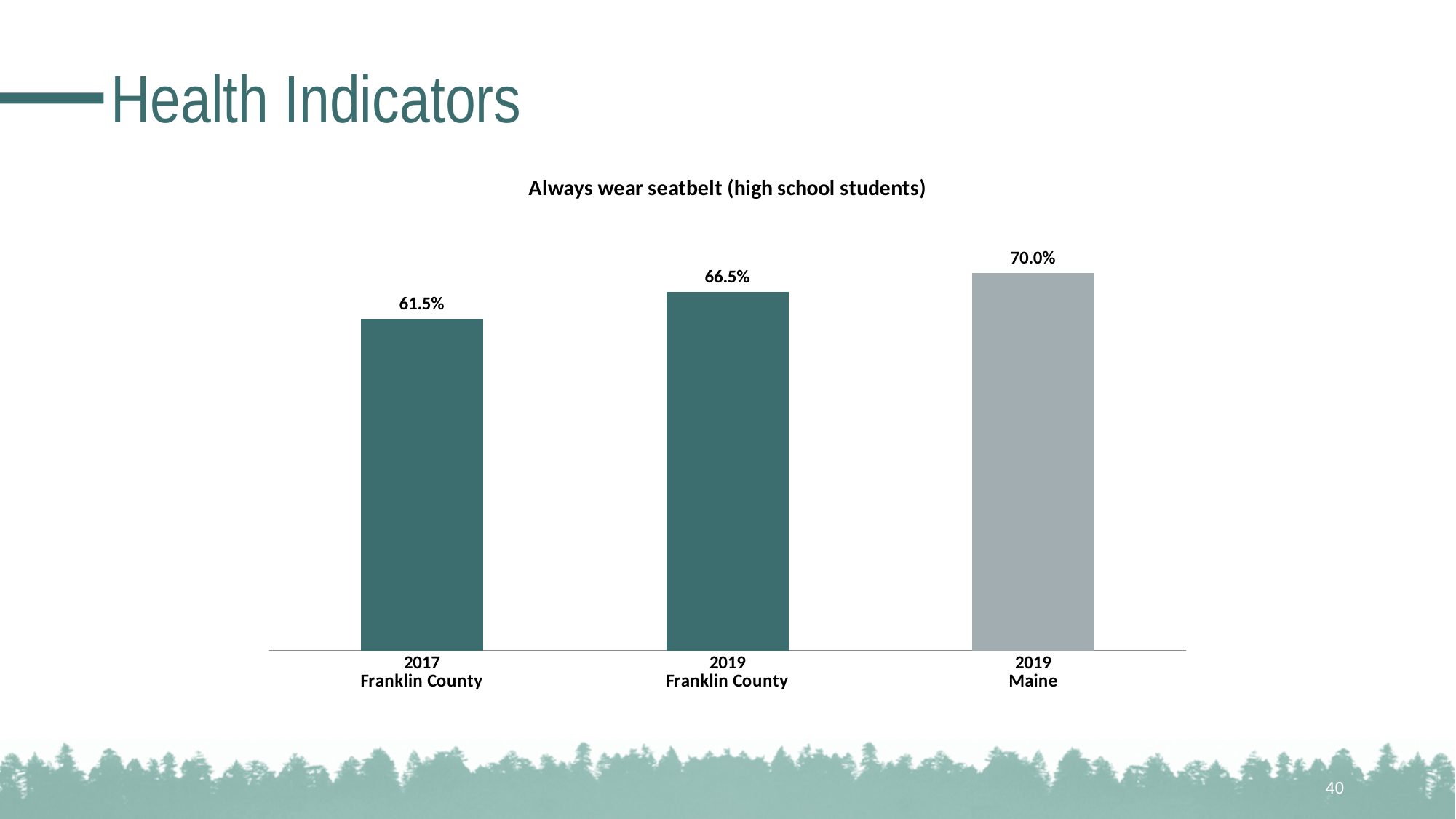
Which is larger, the value for 2019 Franklin County or the value for 2019 Maine? 2019 Maine What kind of chart is shown on the slide? Bar chart What is the title of the chart? Always wear seatbelt (high school students) How many bars are shown in the chart? 3 What is the value for 2017 Franklin County? 61.5% What is the value for 2019 Maine? 70.0% What is the value for 2019 Franklin County? 66.5% Do the values rise or fall from left to right across the bars? Rise Which category has the highest value? 2019 Maine What is the difference between the 2019 Maine value and the 2019 Franklin County value? 3.5% What is the difference between the 2019 Franklin County value and the 2017 Franklin County value? 5.0% Which category has the lowest value? 2017 Franklin County